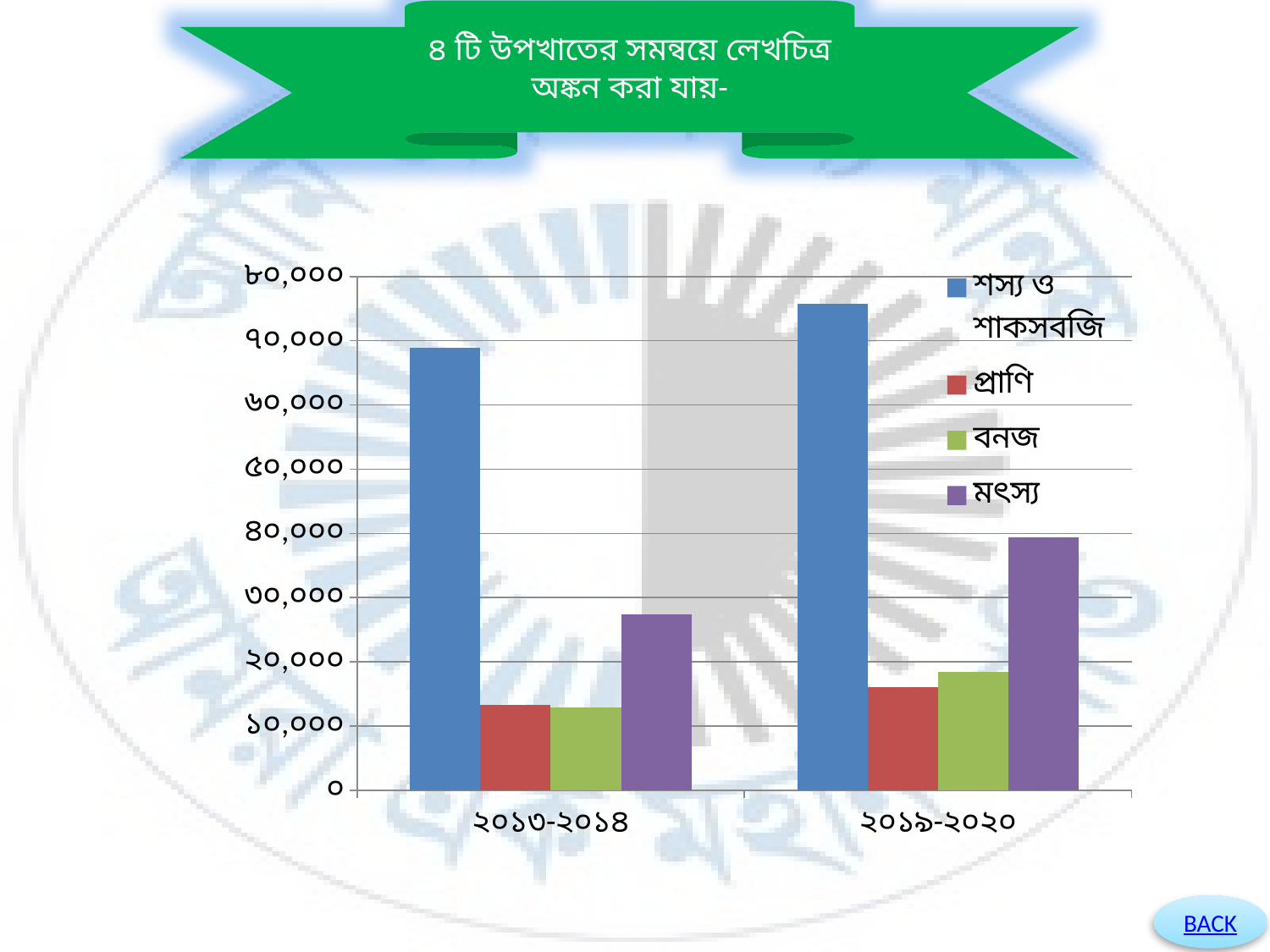
Which is larger: the value for মৎস্য in ২০১৩-২০১৪ or in ২০১৯-২০২০? ২০১৯-২০২০ Does the value for শস্য ও শাকসবজি rise or fall from ২০১৩-২০১৪ to ২০১৯-২০২০? rise Is the value for মৎস্য in ২০১৩-২০১৪ greater or less than ৩০,০০০? less What kind of chart is shown on the slide? bar chart Is the value for মৎস্য in ২০১৯-২০২০ greater or less than ৩০,০০০? greater Is the value for বনজ in ২০১৯-২০২০ greater or less than ২০,০০০? less How many categories are shown on the x axis? 2 Which series has the highest value in ২০১৩-২০১৪? শস্য ও শাকসবজি Which series has the highest value in ২০১৯-২০২০? শস্য ও শাকসবজি How many series does the legend list? 4